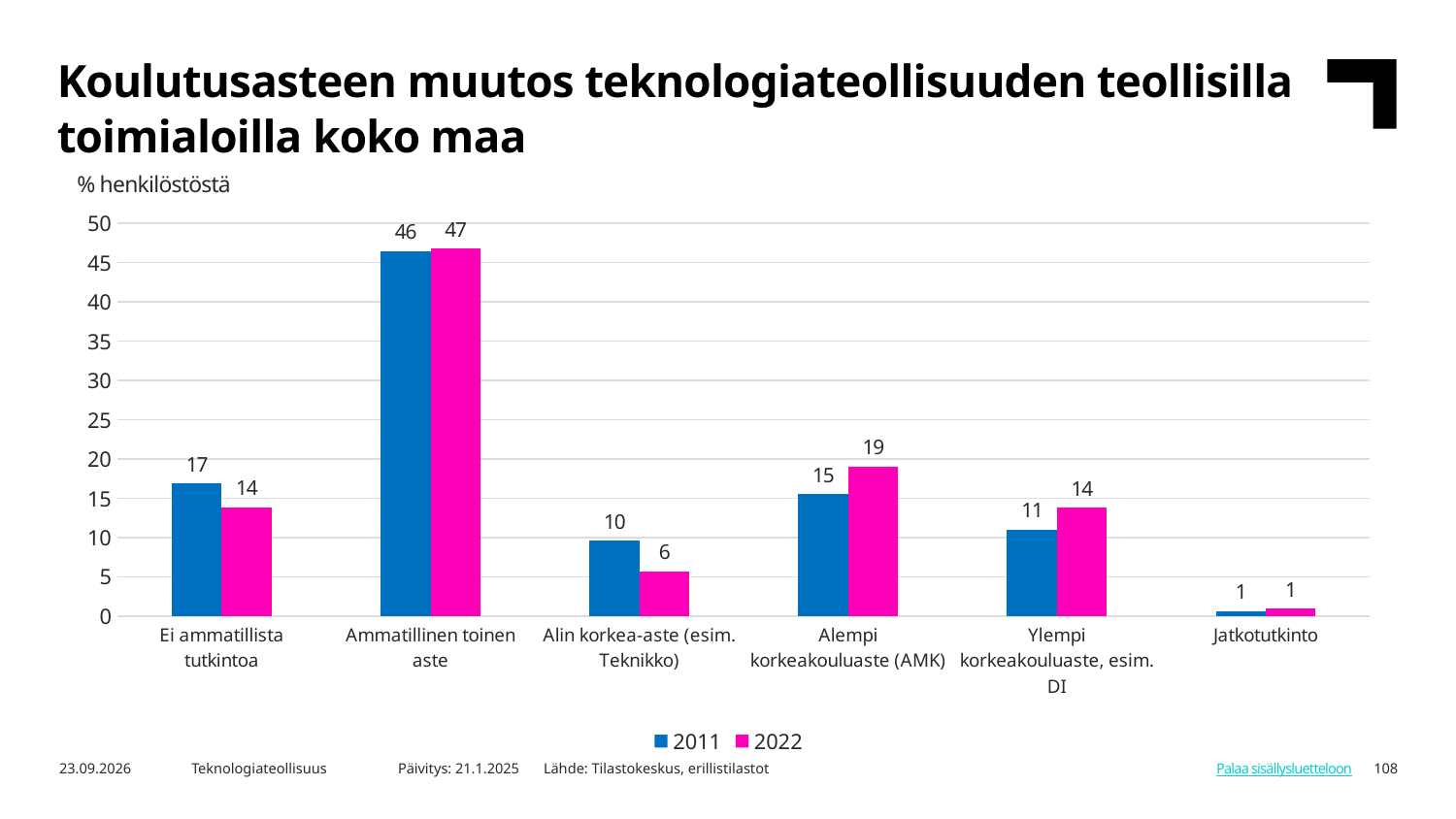
What is the 2022 value for Ammatillinen toinen aste? 47 What unit is indicated above the chart's y axis? % henkilöstöstä How many series does the legend list? 2 Which category has the lowest 2022 value? Jatkotutkinto Which is larger for Ylempi korkeakouluaste, esim. DI: the 2011 value or the 2022 value? 2022 What is the 2011 value for Ei ammatillista tutkintoa? 17 What is the difference between the 2011 and 2022 values for Alin korkea-aste (esim. Teknikko)? 4 How many categories are shown on the x axis? 6 What is the 2022 value for Alempi korkeakouluaste (AMK)? 19 Which category has the highest 2011 value? Ammatillinen toinen aste What kind of chart is shown on the slide? bar chart Is the 2022 value for Ammatillinen toinen aste greater or less than 45? greater